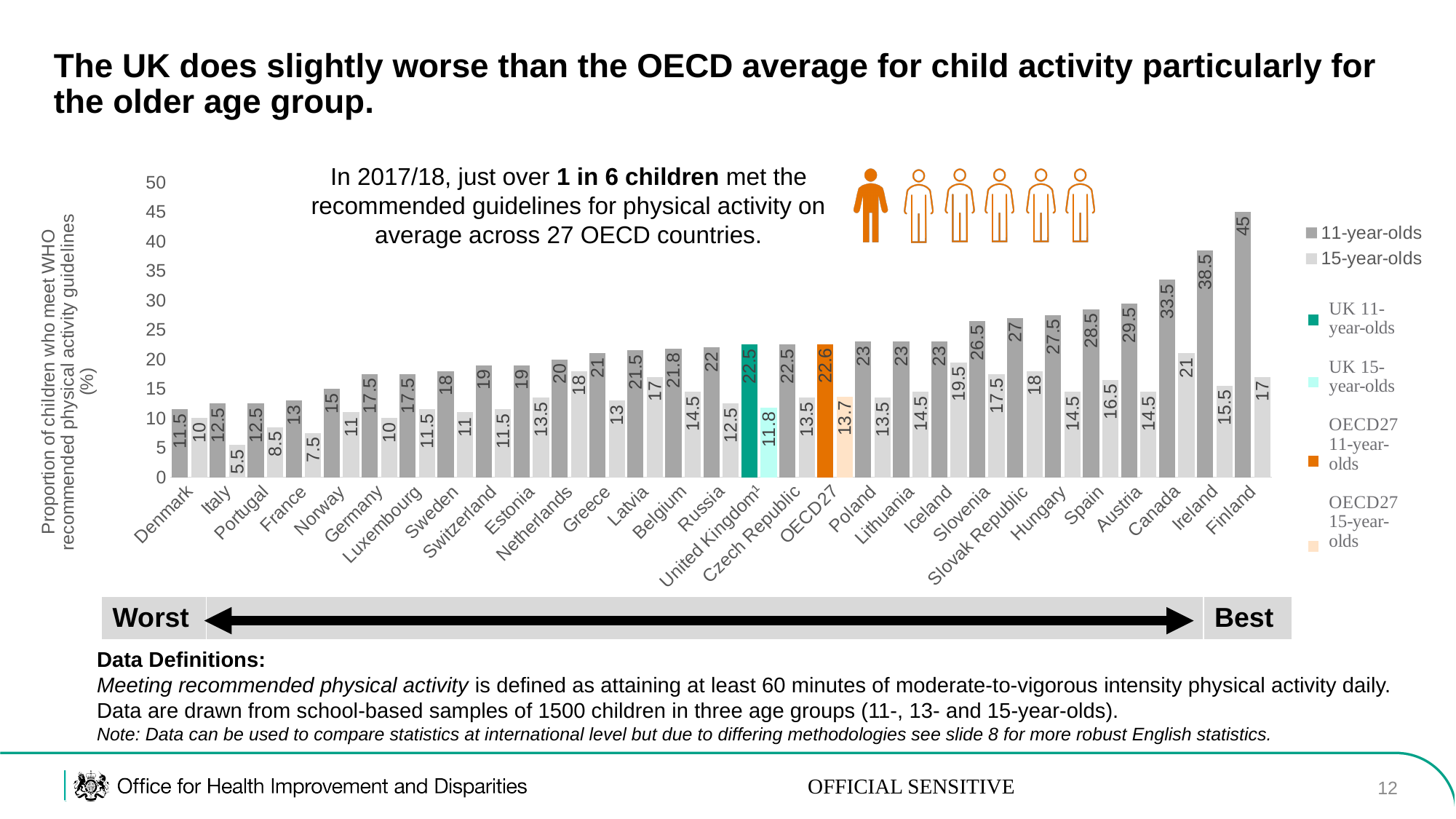
What is the value for 11-year-olds in Ireland? 38.5 Which has the larger value for 15-year-olds, Canada or Ireland? Canada What is the value for 11-year-olds for OECD27? 22.6 Which country has the lowest value for 15-year-olds? Italy What is the difference between the 11-year-olds and 15-year-olds values for Finland? 28 What kind of chart is shown on the slide? Bar chart What is the difference between the OECD27 and United Kingdom values for 11-year-olds? 0.1 What is the value for 11-year-olds in Finland? 45 How many categories (countries plus OECD27) are shown on the x axis? 29 What is the value for 15-year-olds in the United Kingdom? 11.8 Do the values for 11-year-olds generally rise or fall from left to right along the x axis? Rise Which country has the highest value for 11-year-olds? Finland